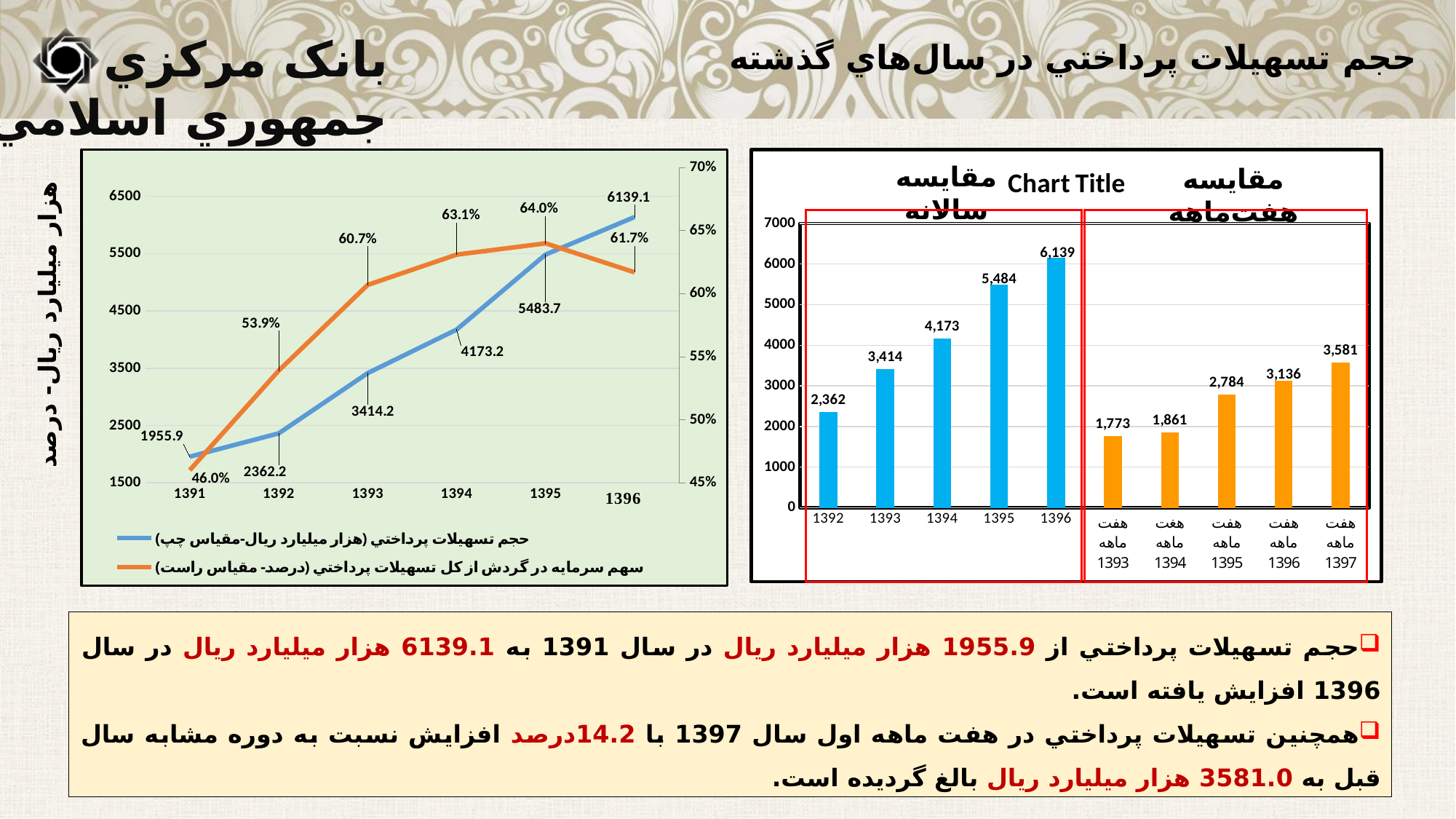
In the line chart on the left, what percentage does the orange line show for 1395? 64.0% In the line chart on the left, what is the value of the blue line (volume of facilities) for 1391? 1955.9 In the line chart on the left, how many series does the legend list? 2 In the bar chart on the right, how many bars are plotted in total? 10 In the line chart on the left, in which year does the orange line (percentage share) reach its highest value? 1395 In the bar chart on the right, which of the orange (seven-month) bars is the lowest? 1393 In the bar chart on the right, what is the value of the orange bar for the seven months of 1397? 3,581 In the bar chart on the right, what is the difference between the seven-month values for 1397 and 1396? 445 What type of chart is shown on the right side of the slide? bar chart In the line chart on the left, what is the difference between the blue line values for 1396 and 1395? 655.4 In the bar chart on the right, what is the value of the blue bar for 1395? 5,484 In the line chart on the left, does the blue line rise or fall from 1391 to 1396? rise